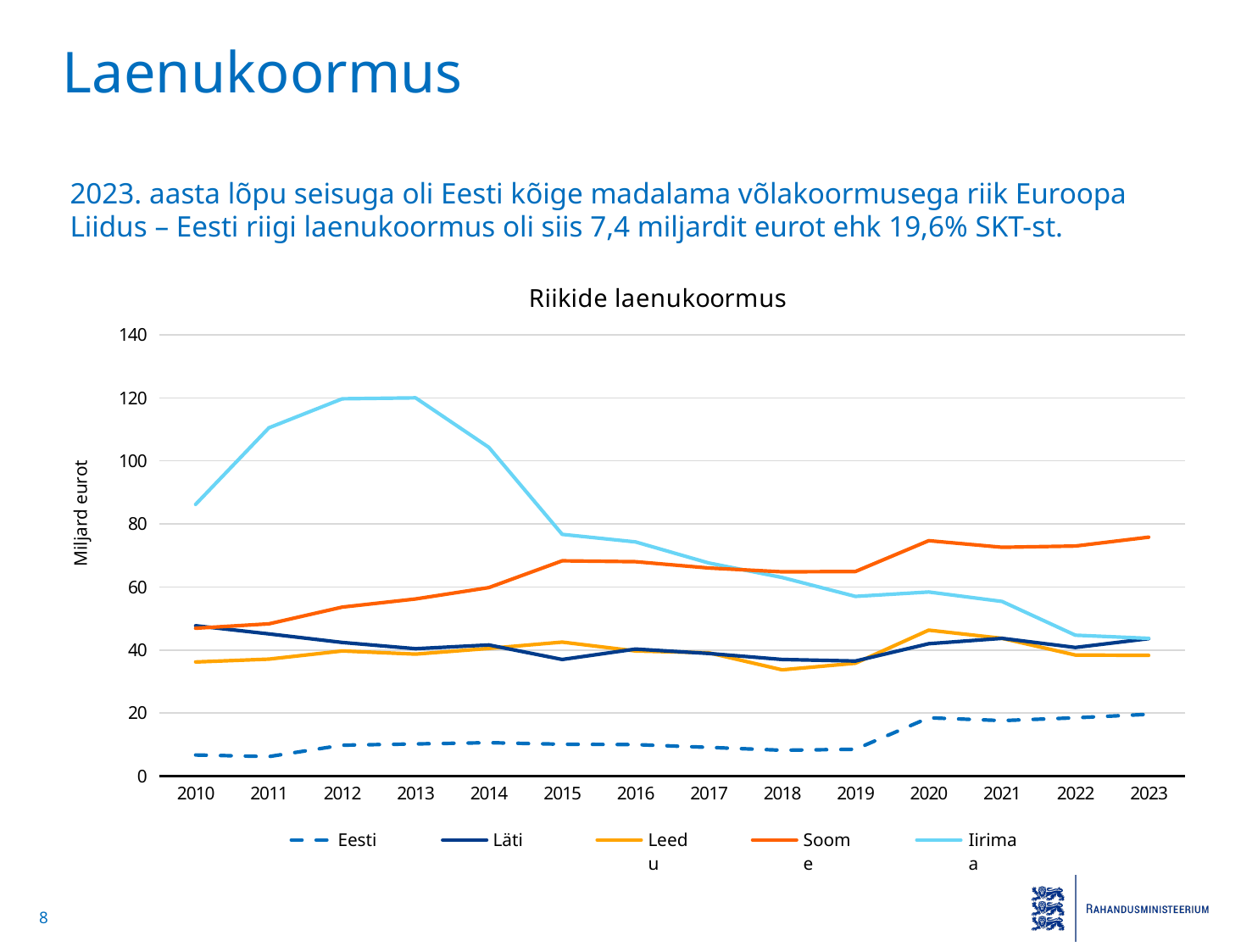
Is the value for Iirimaa in 2013 greater or less than 100? greater Does the Iirimaa line rise or fall from 2013 to 2019? fall Which is larger in 2023, the value for Soome or the value for Iirimaa? Soome Which country had the highest debt in 2012? Iirimaa What is the label of the y axis of the chart? Miljard eurot How many series does the legend of the chart list? 5 What kind of chart is shown on the slide? line chart How many years are shown on the x axis of the chart? 14 Which country had the highest debt in 2023? Soome Is the value for Eesti in 2015 greater or less than 20? less Is the value for Soome in 2020 greater or less than 60? greater Which country had the lowest debt in 2023? Eesti